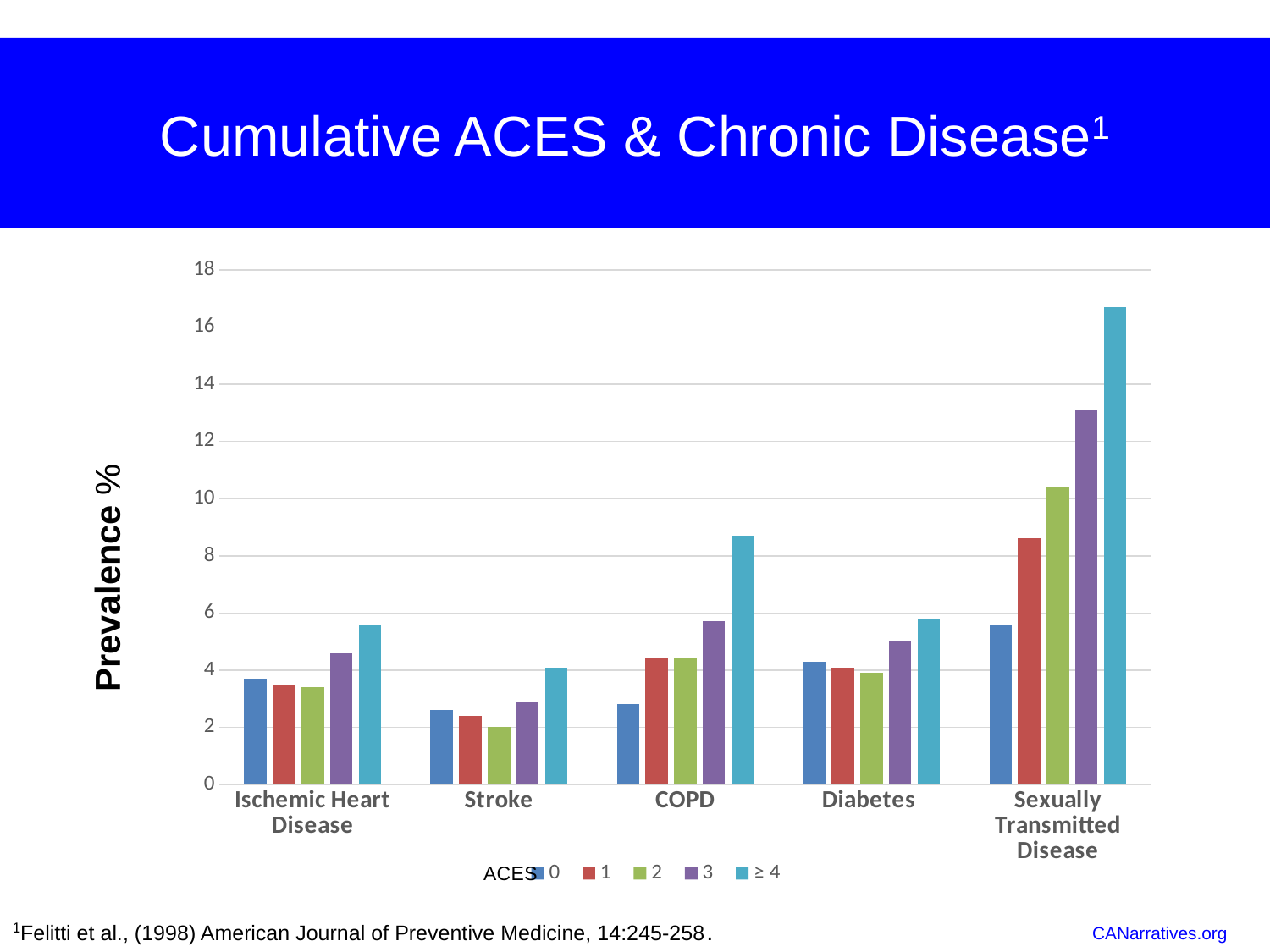
Is the value for 2 ACES in Stroke greater or less than 3? less Which disease category has the tallest bar for ≥ 4 ACES? Sexually Transmitted Disease How many series does the legend list? 5 For Diabetes, which is larger: the bar for 0 ACES or the bar for ≥ 4 ACES? ≥ 4 ACES How many disease categories are shown on the x axis? 5 What kind of chart is shown on the slide? Bar chart What is the label on the y axis? Prevalence % Is the value for ≥ 4 ACES in Sexually Transmitted Disease greater or less than 16? greater Is the value for ≥ 4 ACES in COPD greater or less than 8? greater Which disease category has the shortest bar for ≥ 4 ACES? Stroke For Sexually Transmitted Disease, do the bars rise or fall as the number of ACES increases from 0 to ≥ 4? Rise